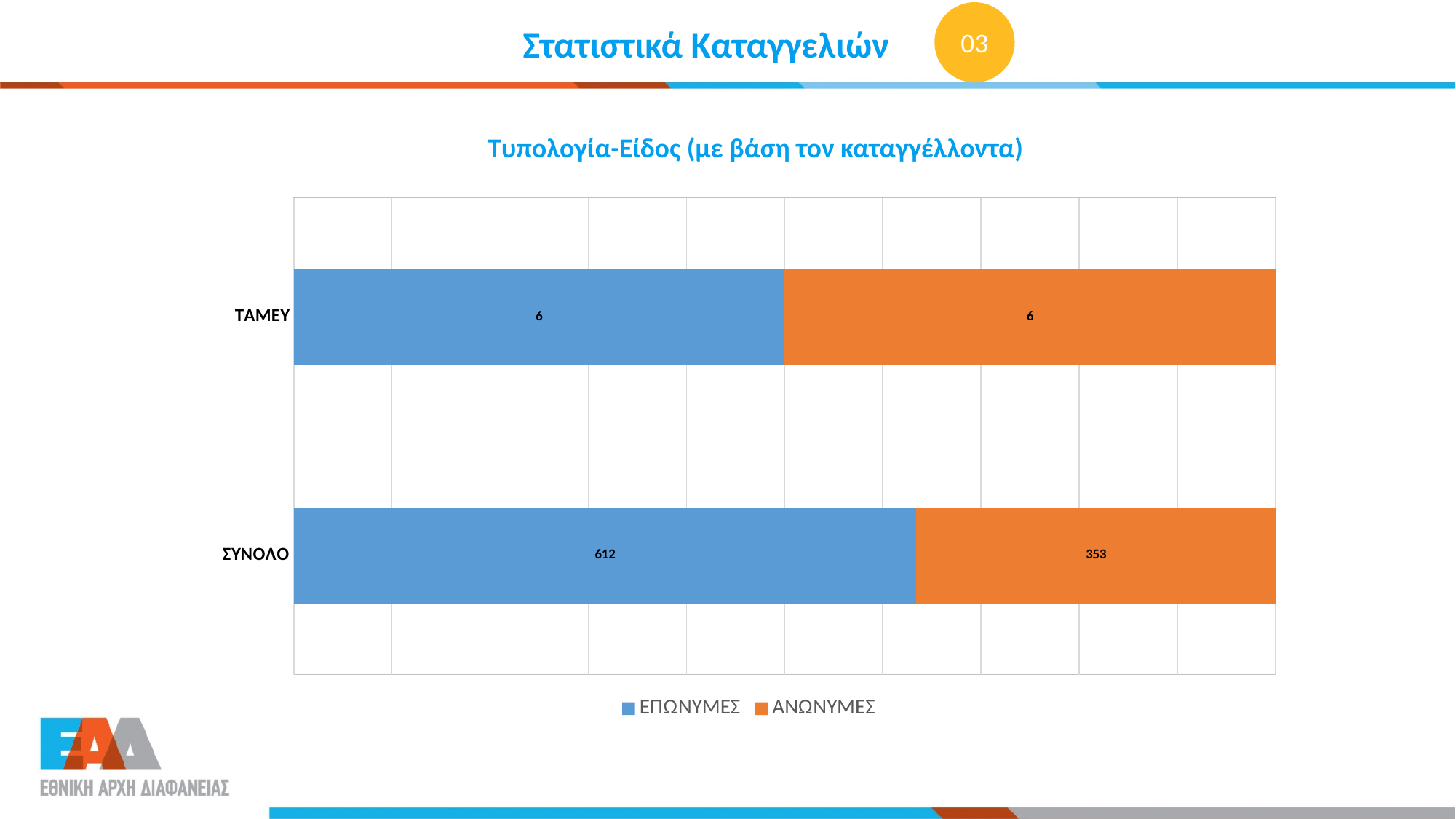
What is the value of ΕΠΩΝΥΜΕΣ for ΣΥΝΟΛΟ? 612 What is the total of the ΣΥΝΟΛΟ bar (ΕΠΩΝΥΜΕΣ plus ΑΝΩΝΥΜΕΣ)? 965 What is the value of ΑΝΩΝΥΜΕΣ for ΣΥΝΟΛΟ? 353 What is the value of ΑΝΩΝΥΜΕΣ for ΤΑΜΕΥ? 6 How many categories are shown on the chart? 2 Which colour represents ΑΝΩΝΥΜΕΣ in the chart? Orange What is the total of the ΤΑΜΕΥ bar (ΕΠΩΝΥΜΕΣ plus ΑΝΩΝΥΜΕΣ)? 12 How many series does the legend list? 2 For ΣΥΝΟΛΟ, which is larger: ΕΠΩΝΥΜΕΣ or ΑΝΩΝΥΜΕΣ? ΕΠΩΝΥΜΕΣ What is the difference between ΕΠΩΝΥΜΕΣ and ΑΝΩΝΥΜΕΣ for ΣΥΝΟΛΟ? 259 What kind of chart is shown on the slide? Stacked bar chart What is the value of ΕΠΩΝΥΜΕΣ for ΤΑΜΕΥ? 6